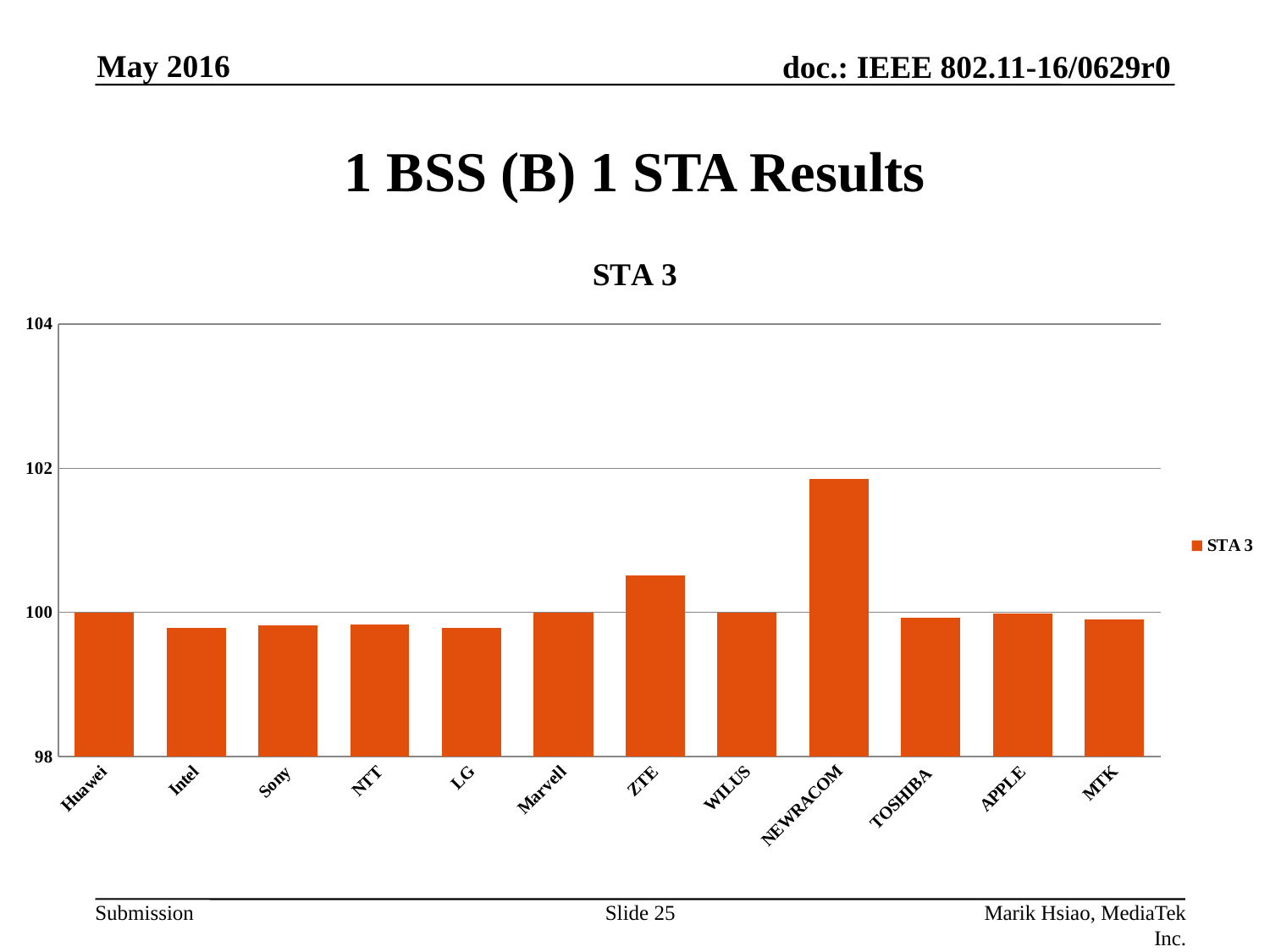
Which is larger, the value for ZTE or the value for LG? ZTE Is the value for ZTE greater or less than 100? greater Is the value for NEWRACOM greater or less than 102? less What kind of chart is shown on the slide? bar chart How many series does the legend list? 1 Which is larger, the value for NEWRACOM or the value for ZTE? NEWRACOM How many companies are shown on the x axis of the chart? 12 Which company has the highest value in the chart? NEWRACOM Is the value for Intel greater or less than 100? less What is the title of the chart? STA 3